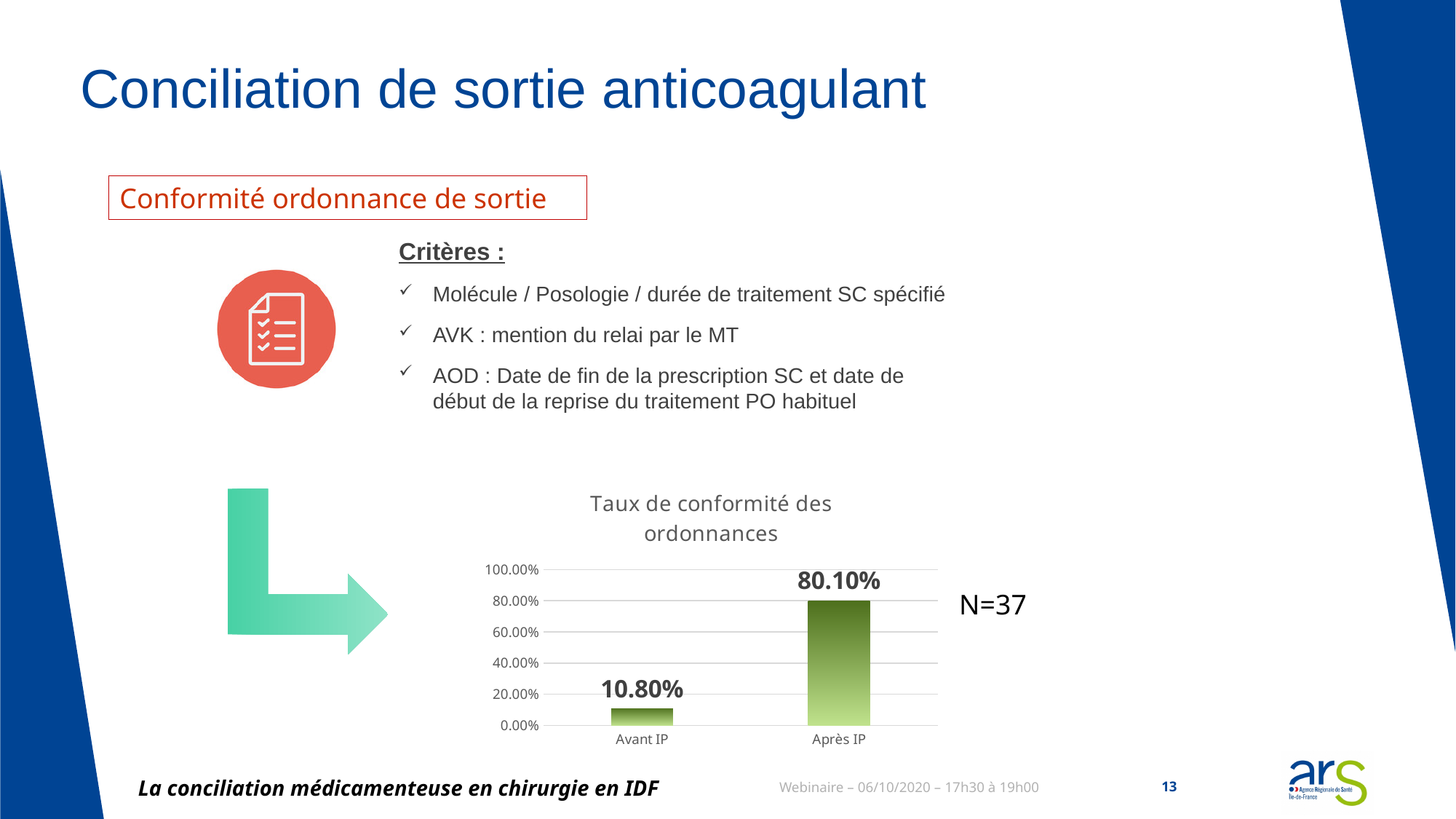
Do the values rise or fall from Avant IP to Après IP? rise What is the difference between the values for Après IP and Avant IP? 69.30% What is the title of the chart? Taux de conformité des ordonnances Which category has the highest value? Après IP What is the value for Après IP? 80.10% Is the value for Avant IP greater or less than 20.00%? less Which is larger, the value for Avant IP or the value for Après IP? Après IP Is the value for Après IP greater or less than 60.00%? greater Which category has the lowest value? Avant IP What kind of chart is shown? bar chart How many categories are shown on the x axis? 2 What is the value for Avant IP? 10.80%